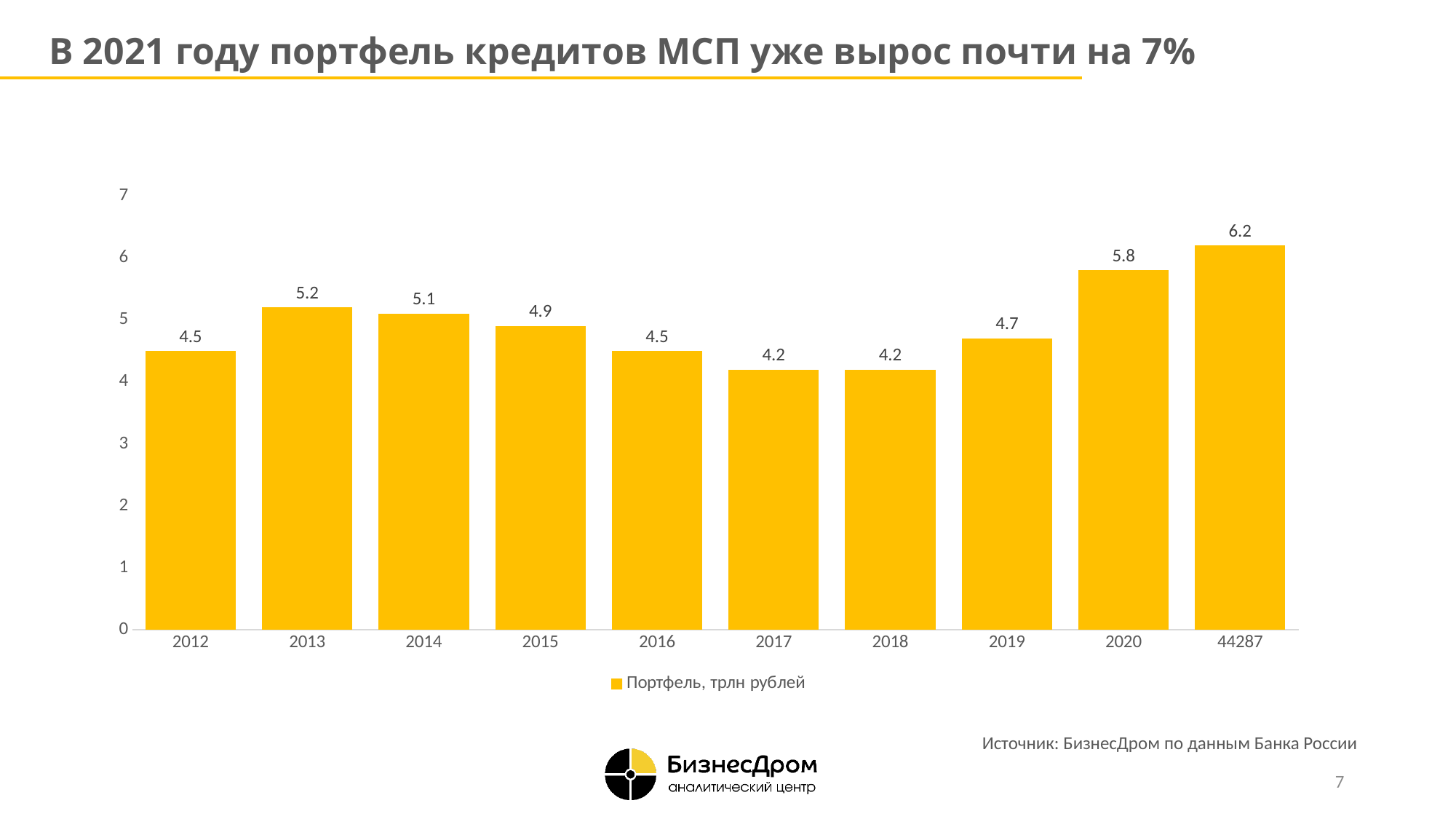
What is the value for 2013? 5.2 What is the legend entry for the series? Портфель, трлн рублей Is the value for 2015 greater or less than 4? greater How many bars are shown on the chart? 10 How many series does the legend list? 1 What is the lowest value shown on the chart? 4.2 Which category has the highest value? 44287 What is the value for 2020? 5.8 Which is larger, the value for 2014 or the value for 2016? 2014 What kind of chart is shown on the slide? bar chart What is the value for 2017? 4.2 What is the difference between the values for 2020 and 2019? 1.1